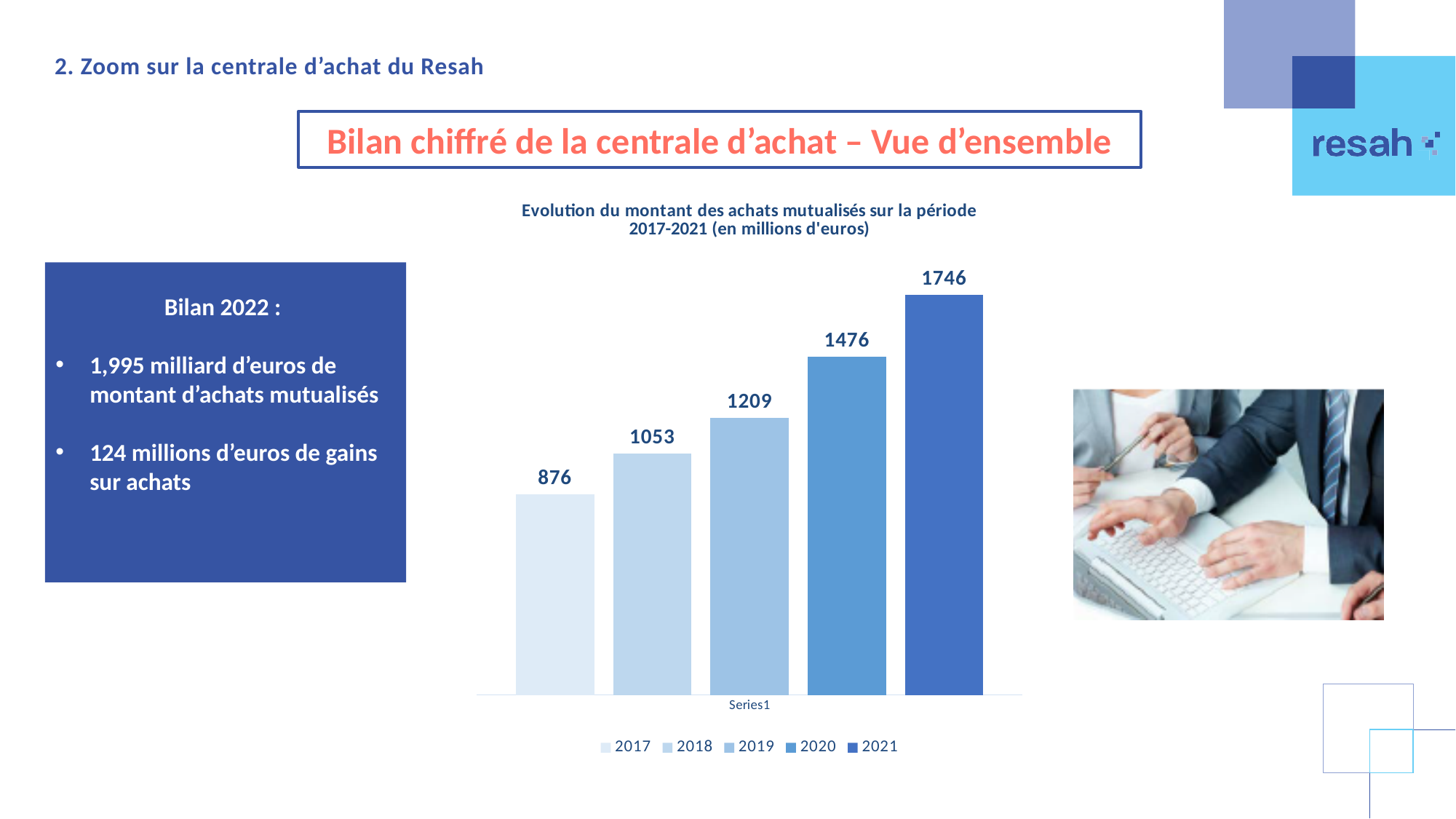
How many entries does the legend list? 5 What is the value for 2019 in the chart? 1209 What is the difference between the values for 2021 and 2017? 870 How many years are shown in the chart? 5 What kind of chart is shown on the slide? Bar chart What is the value for 2017 in the chart? 876 Do the values rise or fall from 2017 to 2021? Rise What is the difference between the values for 2020 and 2019? 267 What is the value for 2021 in the chart? 1746 Which year has the highest value in the chart? 2021 Which year has the lowest value in the chart? 2017 Which is larger, the value for 2018 or the value for 2020? 2020